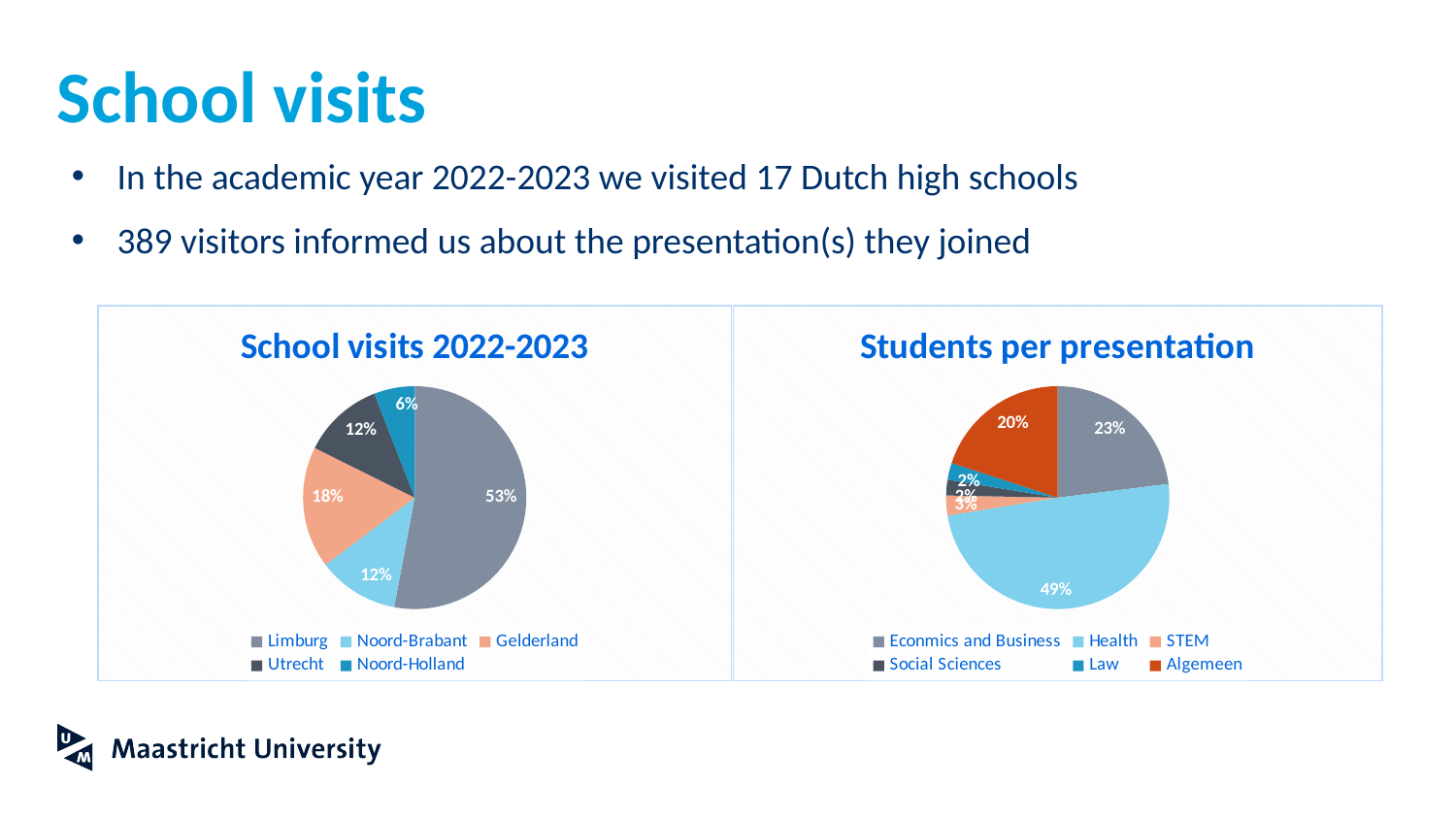
In the 'School visits 2022-2023' chart, what is the difference in percentage points between Limburg and Gelderland? 35 In the 'Students per presentation' chart, which presentation has the largest share of students? Health In the 'School visits 2022-2023' chart, what share of school visits was in Noord-Holland? 6% In the 'School visits 2022-2023' chart, what share of school visits was in Limburg? 53% In the 'Students per presentation' chart, what share of students attended the Health presentation? 49% How many categories does the legend of the 'School visits 2022-2023' chart list? 5 In the 'School visits 2022-2023' chart, which province has the smallest share of school visits? Noord-Holland What kind of chart is 'Students per presentation'? Pie chart In the 'School visits 2022-2023' chart, which province has the largest share of school visits? Limburg In the 'Students per presentation' chart, which is larger: the share for Econmics and Business or the share for Algemeen? Econmics and Business